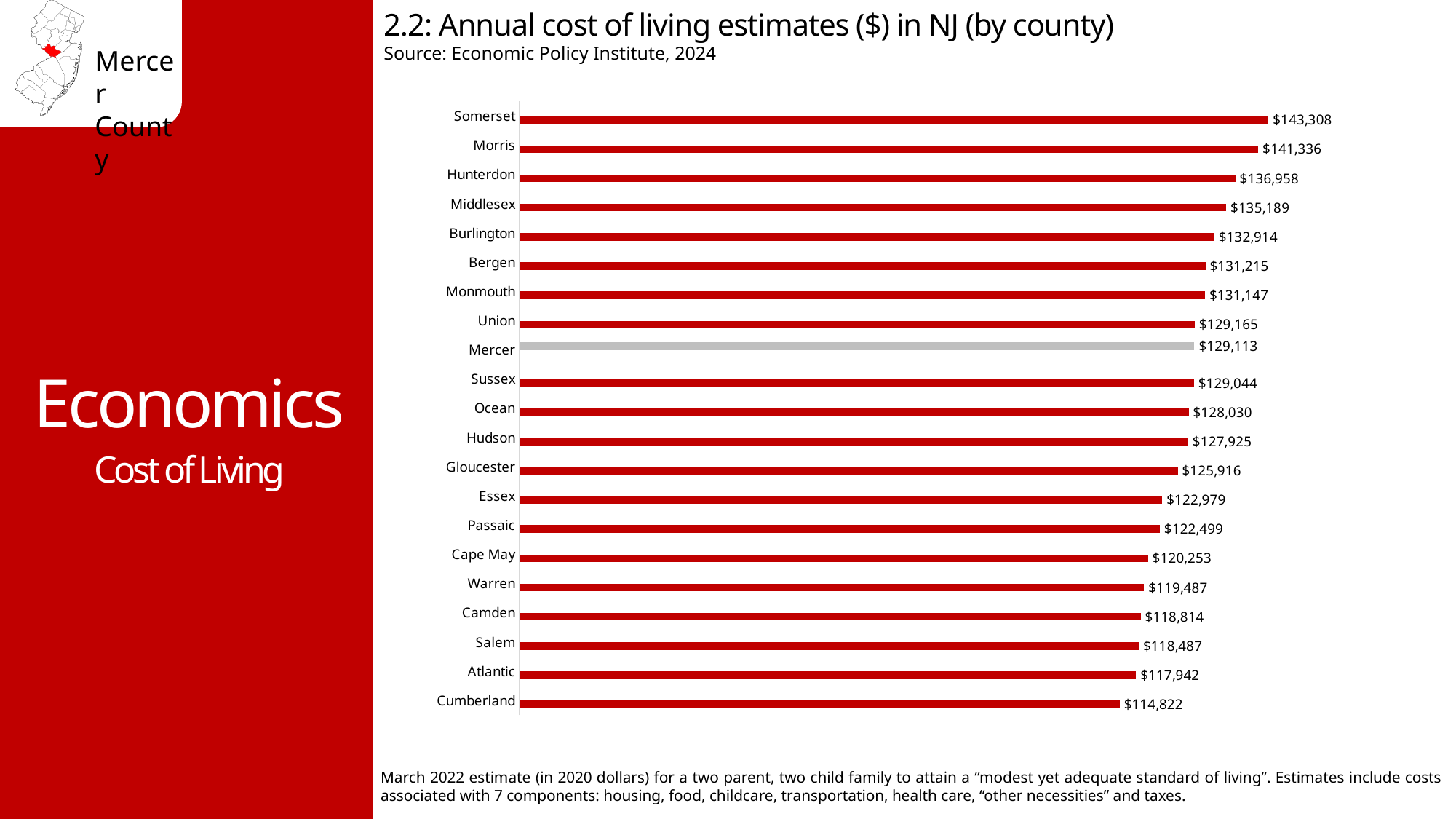
Which county has a higher cost of living estimate, Essex or Camden? Essex What is the annual cost of living estimate for Mercer County? $129,113 Which county has the lowest annual cost of living estimate? Cumberland Which county has a higher cost of living estimate, Morris or Hunterdon? Morris What type of chart is used to show the cost of living estimates? Bar chart How many counties are shown in the chart? 21 What is the difference between the cost of living estimates for Somerset and Cumberland counties? $28,486 What is the annual cost of living estimate for Somerset County? $143,308 Which county's bar is shown in grey instead of red? Mercer What is the annual cost of living estimate for Hudson County? $127,925 Which county has the highest annual cost of living estimate? Somerset What is the difference between the cost of living estimates for Mercer and Cumberland counties? $14,291